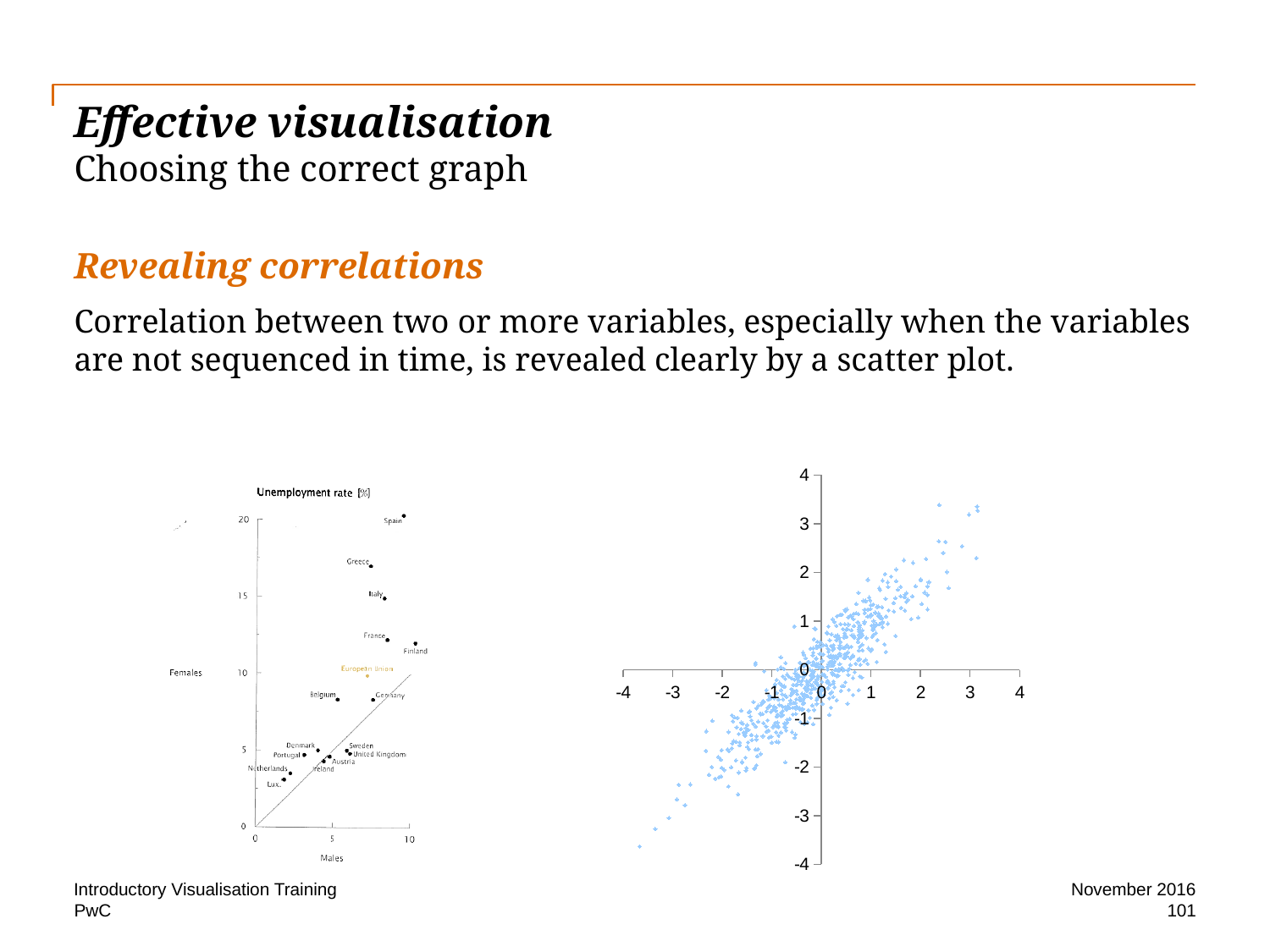
In the left chart 'Unemployment rate [%]', is the female unemployment rate for Greece greater or less than 15? greater In the left chart 'Unemployment rate [%]', is the female unemployment rate for Netherlands greater or less than 5? less In the right chart with axes from -4 to 4, do the points generally rise or fall as the x value increases? rise What kind of chart is the right chart with axes from -4 to 4? scatter plot In the left chart 'Unemployment rate [%]', which labelled country has the highest female unemployment rate? Spain In the left chart 'Unemployment rate [%]', what is the label on the vertical axis? Females In the left chart 'Unemployment rate [%]', is the female unemployment rate for Spain greater or less than 15? greater In the left chart 'Unemployment rate [%]', which has the higher female unemployment rate, Greece or Germany? Greece What kind of chart is the left chart titled 'Unemployment rate [%]'? scatter plot In the left chart 'Unemployment rate [%]', which labelled country has the lowest female unemployment rate? Lux. In the left chart 'Unemployment rate [%]', what is the label on the horizontal axis? Males